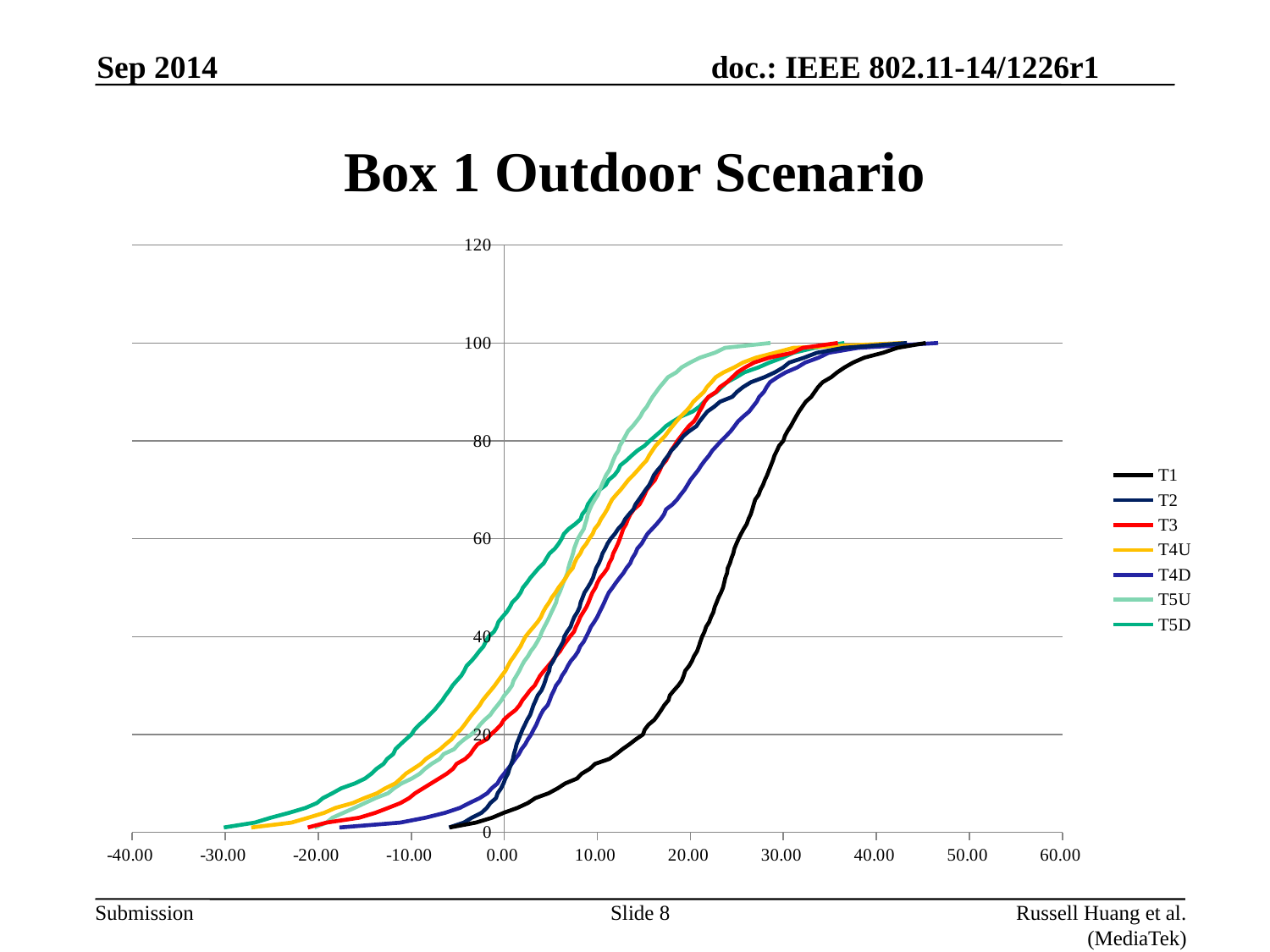
Is the value of T1 at x = 20.00 greater or less than 40? less How many series does the legend list? 7 Which series is drawn in black in the legend? T1 Is the value of T1 at x = 10.00 greater or less than 20? less What kind of chart is shown on the slide? line chart Is the value of T5D at x = -20.00 greater or less than 20? less At x = 20.00, which series has the higher value, T1 or T5U? T5U What is the title of the chart? Box 1 Outdoor Scenario Do the values of the T1 series rise or fall as the x axis increases? rise